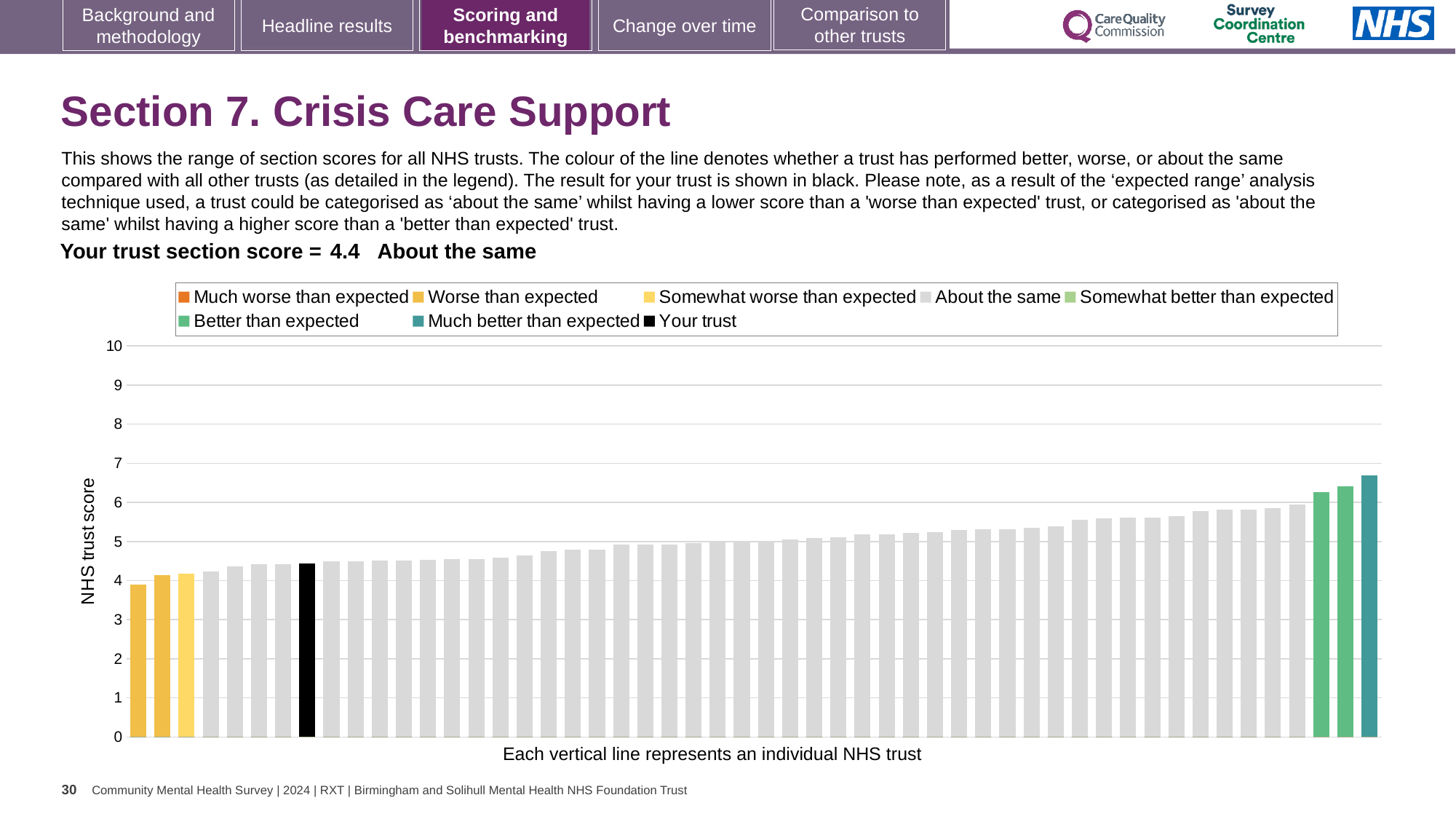
Is the value of the tallest bar greater or less than 7? less What is the label on the vertical axis of the chart? NHS trust score What is the section score for your trust shown on the slide? 4.4 What kind of chart is shown on the slide? bar chart Is the value for your trust (the black bar) greater or less than 5? less What colour is used for the bar representing your trust? black How many bars are coloured as 'Better than expected'? 2 Which performance category is your trust placed in for Section 7? About the same Which legend category does the tallest bar belong to? Much better than expected Is the value of the tallest bar greater or less than 6? greater How many entries does the chart legend list? 8 Do the bar values rise or fall from left to right across the chart? rise